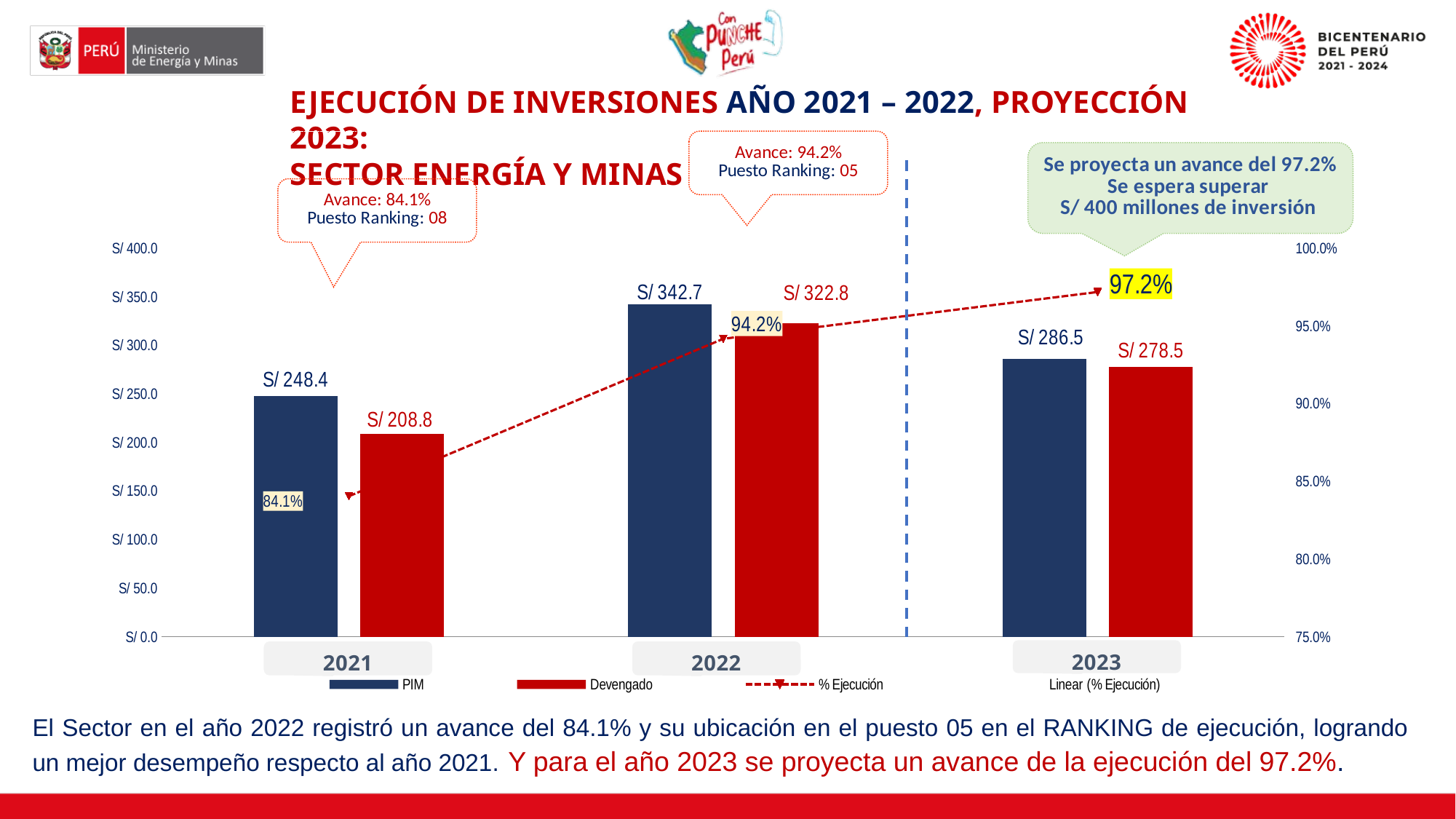
Which year has the lowest Devengado value? 2021 Which year has the highest PIM value? 2022 What is the Devengado value for 2021? S/ 208.8 What is the difference between PIM and Devengado in 2023? S/ 8.0 What is the PIM value for 2022? S/ 342.7 How many entries does the legend list? 4 What is the % Ejecución value for 2023? 97.2% Which is larger in 2021, PIM or Devengado? PIM What kind of chart is shown? Bar chart with a line Does the % Ejecución line rise or fall from 2021 to 2023? Rise Is the Devengado value for 2022 greater or less than S/ 300.0? greater How many years are shown on the x axis? 3